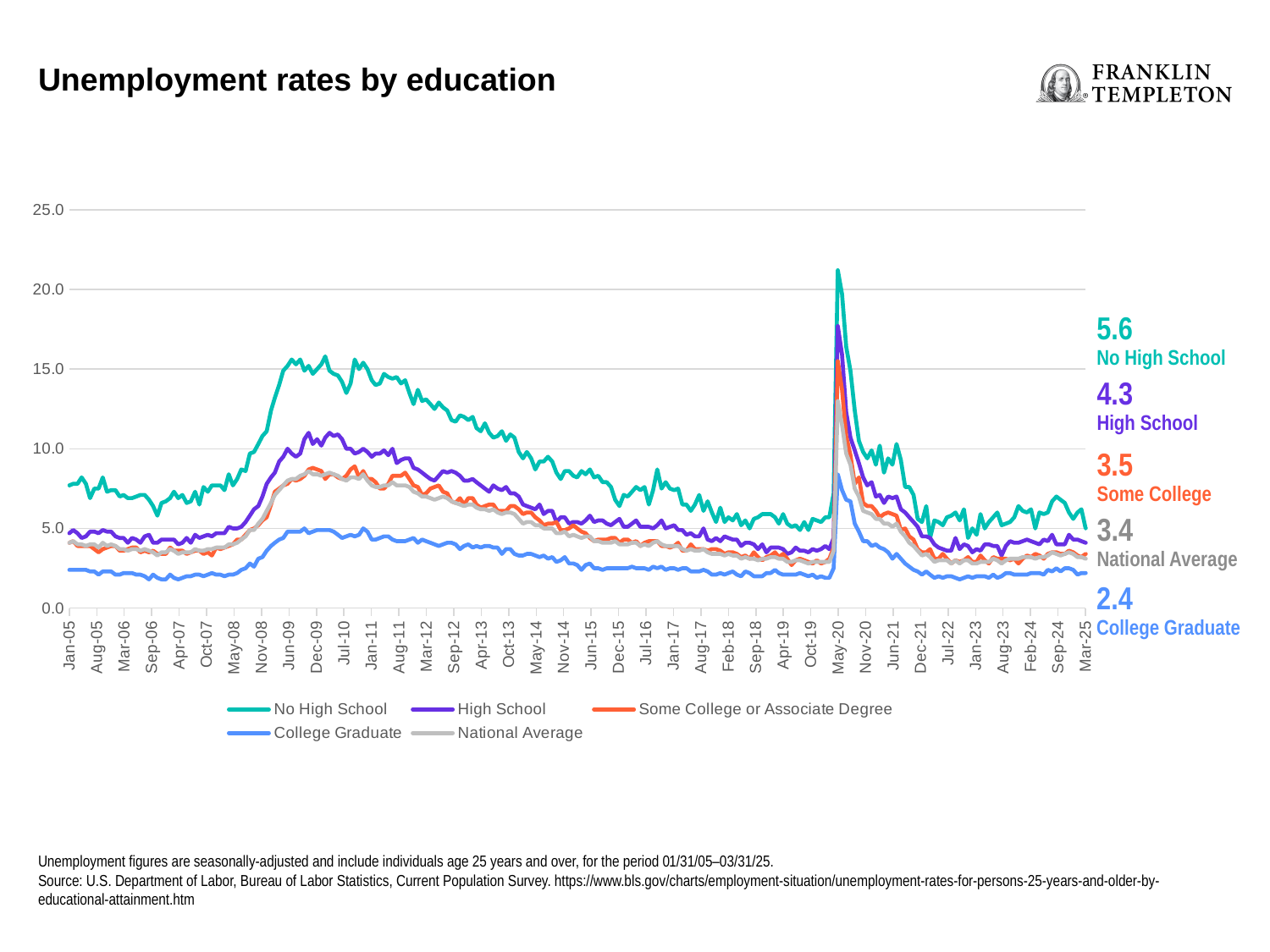
Which education group has the lowest latest unemployment rate? College Graduate What is the difference between the latest No High School rate and the latest College Graduate rate? 3.2 What is the title of the chart? Unemployment rates by education What is the latest value shown for the National Average? 3.4 What kind of chart is shown on the slide? line chart Which education group has the highest latest unemployment rate? No High School Is the latest rate for Some College higher or lower than the latest rate for High School? lower How many series does the legend list? 5 Is the peak value of the No High School line around May-20 greater or less than 20.0? greater What is the latest unemployment rate shown for No High School? 5.6 What is the latest unemployment rate shown for College Graduate? 2.4 What is the latest unemployment rate shown for High School? 4.3